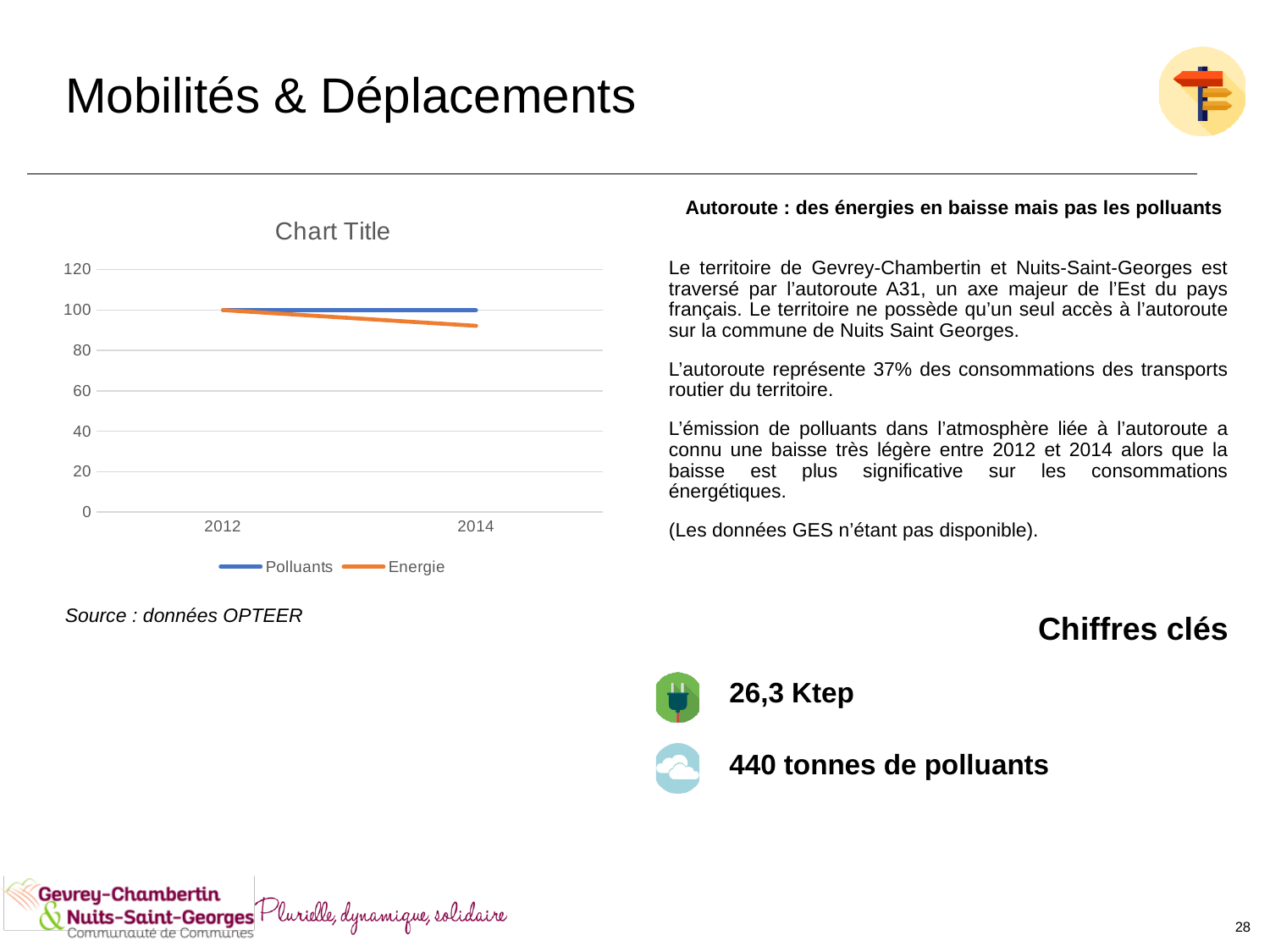
Does the Energie series rise or fall from 2012 to 2014? fall Which series shows the larger decrease between 2012 and 2014? Energie What is the value of the Polluants series in 2012? 100 What is the value of the Energie series in 2012? 100 Is the value of the Energie series in 2014 greater or less than 80? greater Which colour is used for the Energie series in the chart? orange What is the title shown above the chart? Chart Title How many series does the chart legend list? 2 How many years are shown on the x axis of the chart? 2 In 2014, which series has the higher value, Polluants or Energie? Polluants Is the value of the Energie series in 2014 greater or less than 100? less What kind of chart is shown on the slide? line chart